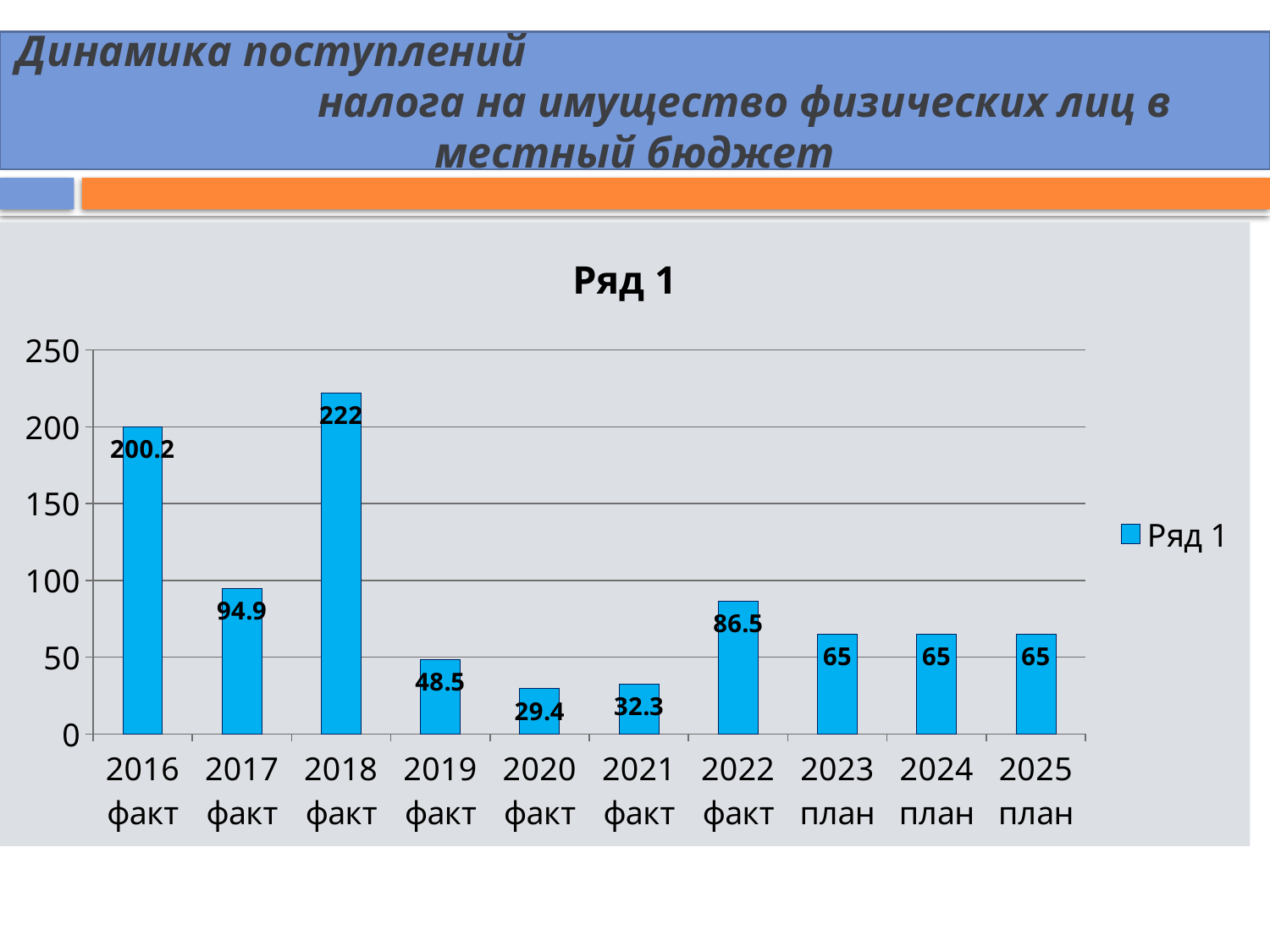
Which is larger, the value for 2017 факт or the value for 2022 факт? 2017 факт How many series does the legend list? 1 How many categories are shown on the x axis? 10 What is the value for 2022 факт? 86.5 What kind of chart is shown on the slide? bar chart What is the difference between the values for 2018 факт and 2016 факт? 21.8 Is the value for 2019 факт greater or less than 50? less Which category has the highest value? 2018 факт What is the value for 2018 факт? 222 What is the value for 2020 факт? 29.4 What is the title of the chart? Ряд 1 Which category has the lowest value? 2020 факт